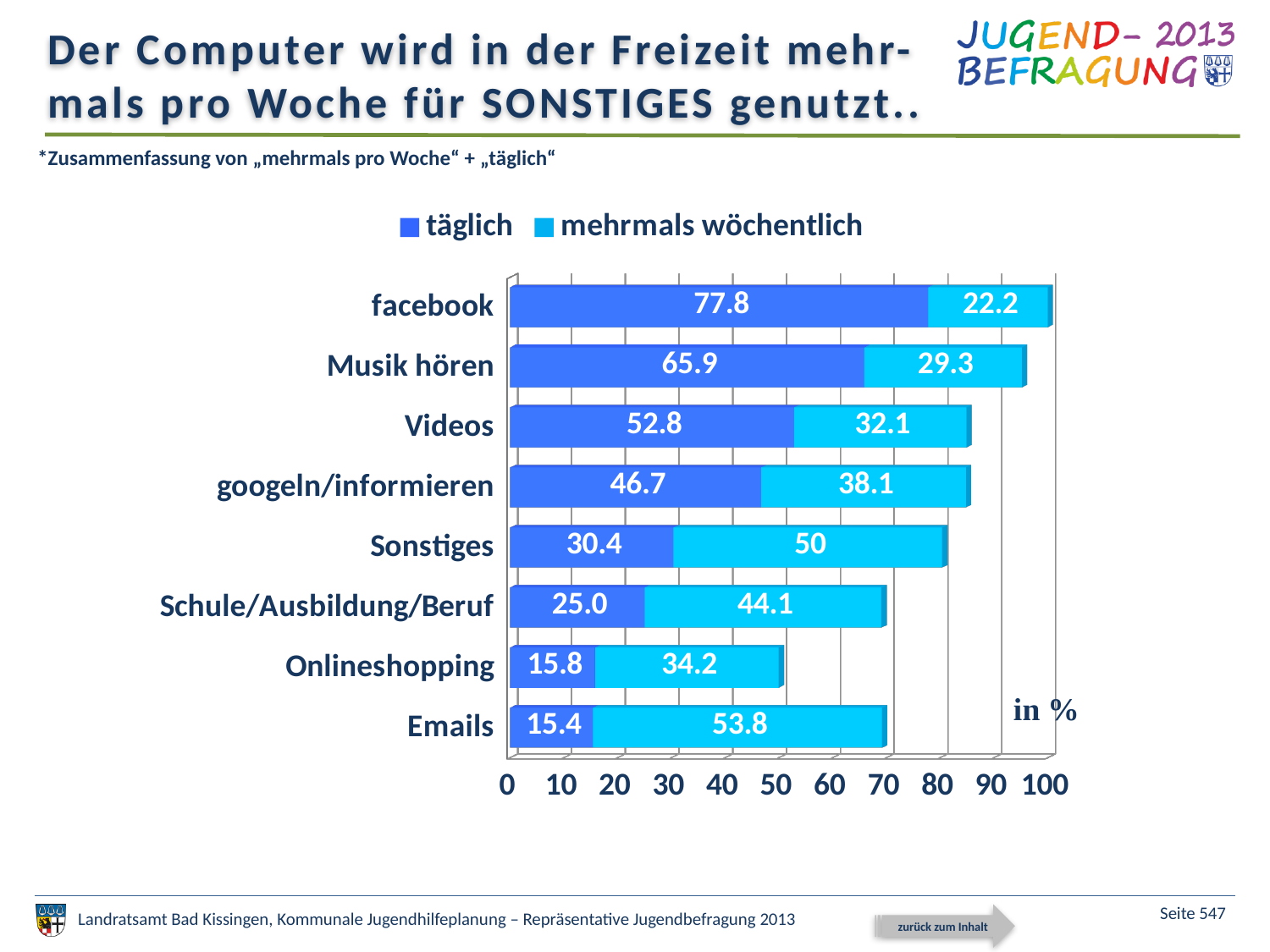
Which category has the highest 'täglich' value? facebook Which category has the highest 'mehrmals wöchentlich' value? Emails What kind of chart is shown on the slide? Stacked bar chart Which category has the lowest 'mehrmals wöchentlich' value? facebook What is the 'mehrmals wöchentlich' value for Sonstiges? 50 How many series does the legend list? 2 What is the difference between the 'täglich' values for facebook and Emails? 62.4 What is the 'täglich' value for facebook? 77.8 What is the total of the stacked bar for Musik hören? 95.2 How many categories are shown in the chart? 8 Which has the larger 'täglich' value, Videos or googeln/informieren? Videos What is the 'mehrmals wöchentlich' value for Emails? 53.8